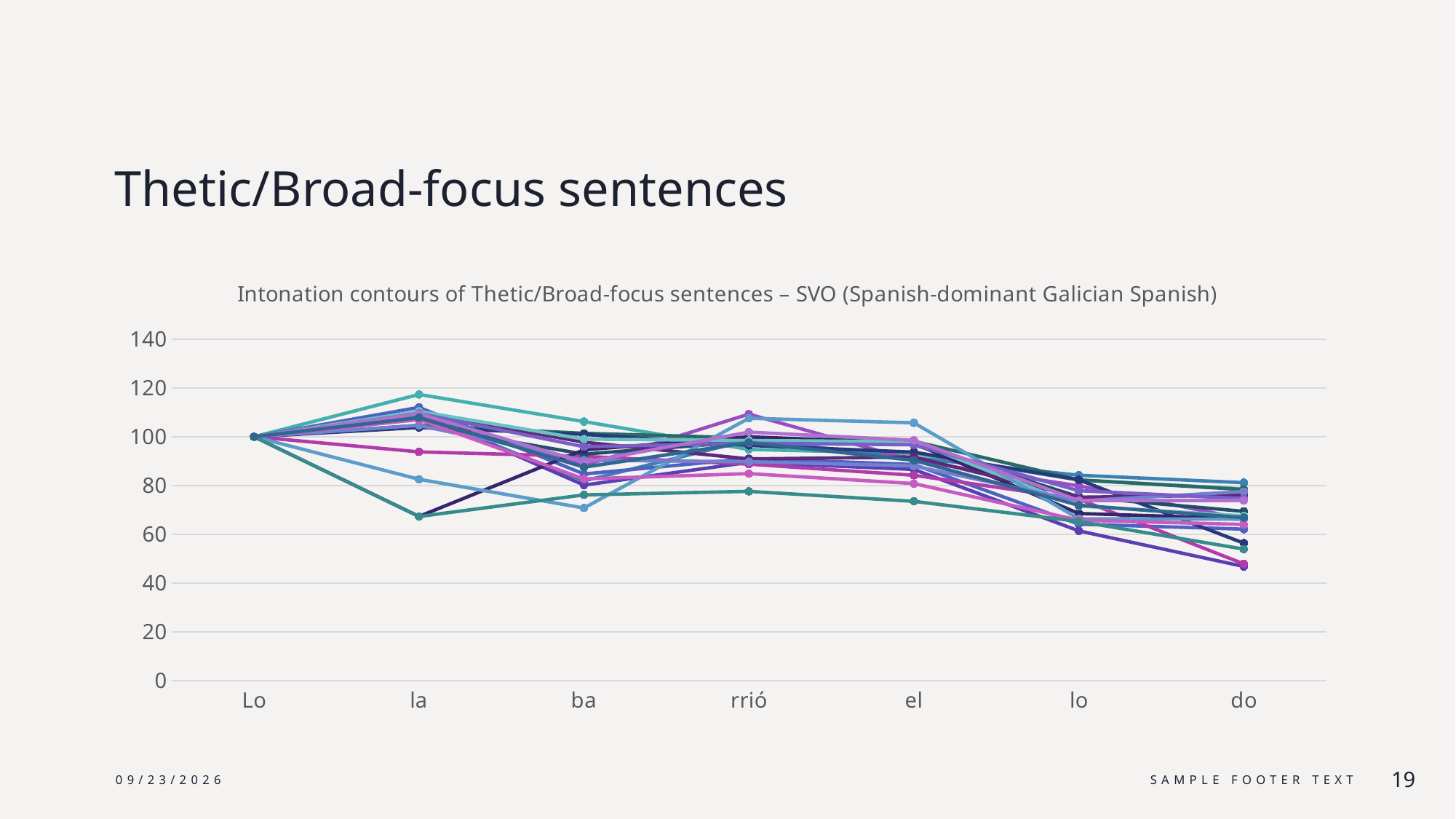
Is the lowest value at the category do greater or less than 60? less What is the title of the chart? Intonation contours of Thetic/Broad-focus sentences – SVO (Spanish-dominant Galician Spanish) How many categories are shown along the x axis? 7 Do the lines generally rise or fall from Lo to do? fall Which category has the lowest plotted values overall, la or do? do Is the highest value at the category la greater or less than 100? greater What is the maximum value shown on the y axis? 140 What is the first category on the x axis? Lo Is the lowest value at the category la greater or less than 80? less What kind of chart is shown on the slide? line chart What value do all the lines share at the category Lo? 100